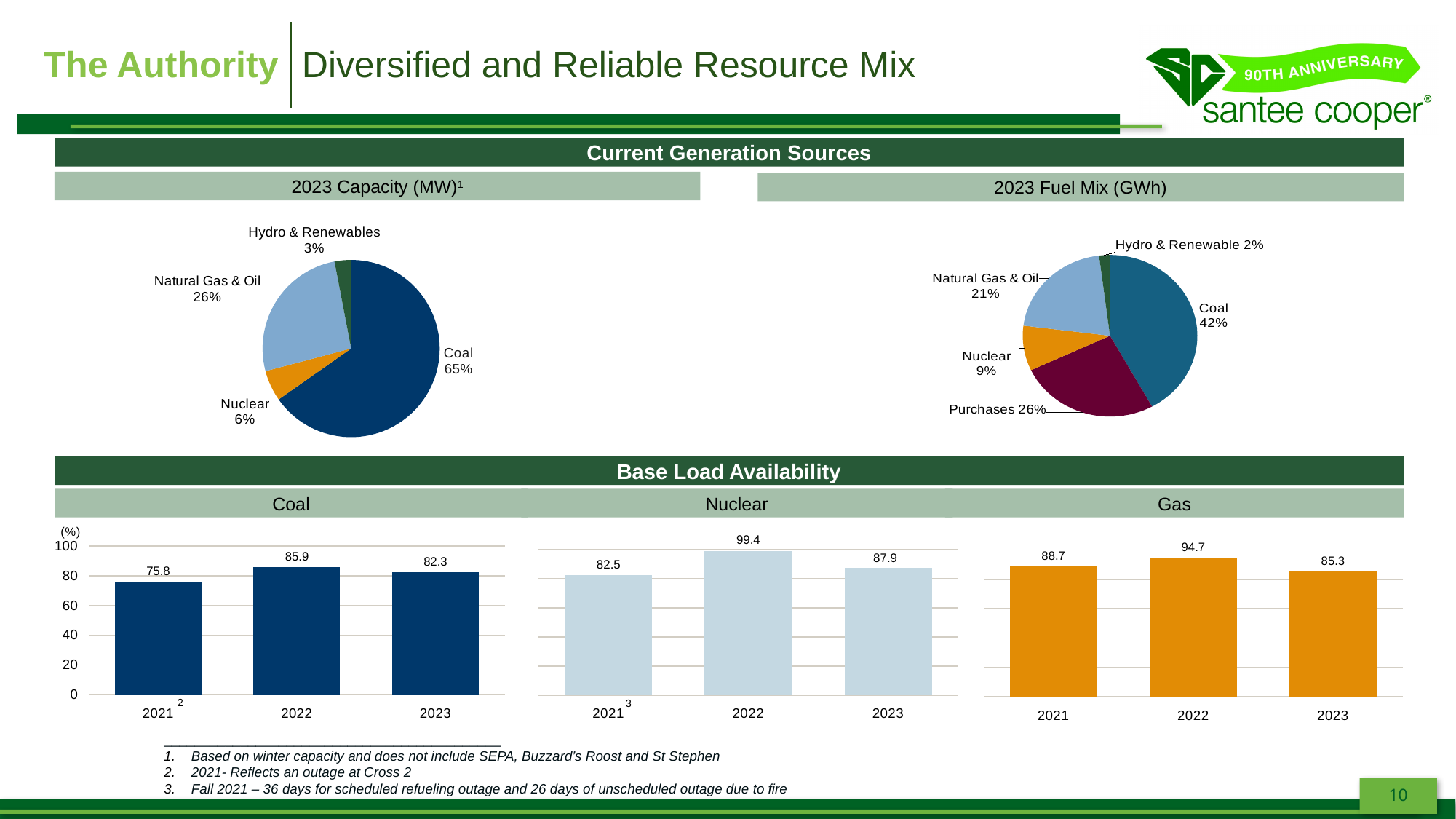
In the Gas base load availability chart, what is the value for 2021? 88.7 In the Gas base load availability chart, what is the difference between the 2022 and 2023 values? 9.4 In the Coal base load availability chart, what is the value for 2022? 85.9 How many slices does the 2023 Fuel Mix (GWh) pie chart have? 5 In the 2023 Fuel Mix (GWh) pie chart, what share does Purchases have? 26% What kind of chart is used for the Gas base load availability? Bar chart In the 2023 Fuel Mix (GWh) pie chart, which category has the largest share? Coal In the 2023 Capacity (MW) pie chart, which category has the smallest share? Hydro & Renewables In the Nuclear base load availability chart, which year has the highest value? 2022 In the 2023 Capacity (MW) pie chart, what share does Coal have? 65% In the Coal base load availability chart, which is larger, the value for 2021 or the value for 2023? 2023 In the Nuclear base load availability chart, what is the value for 2021? 82.5